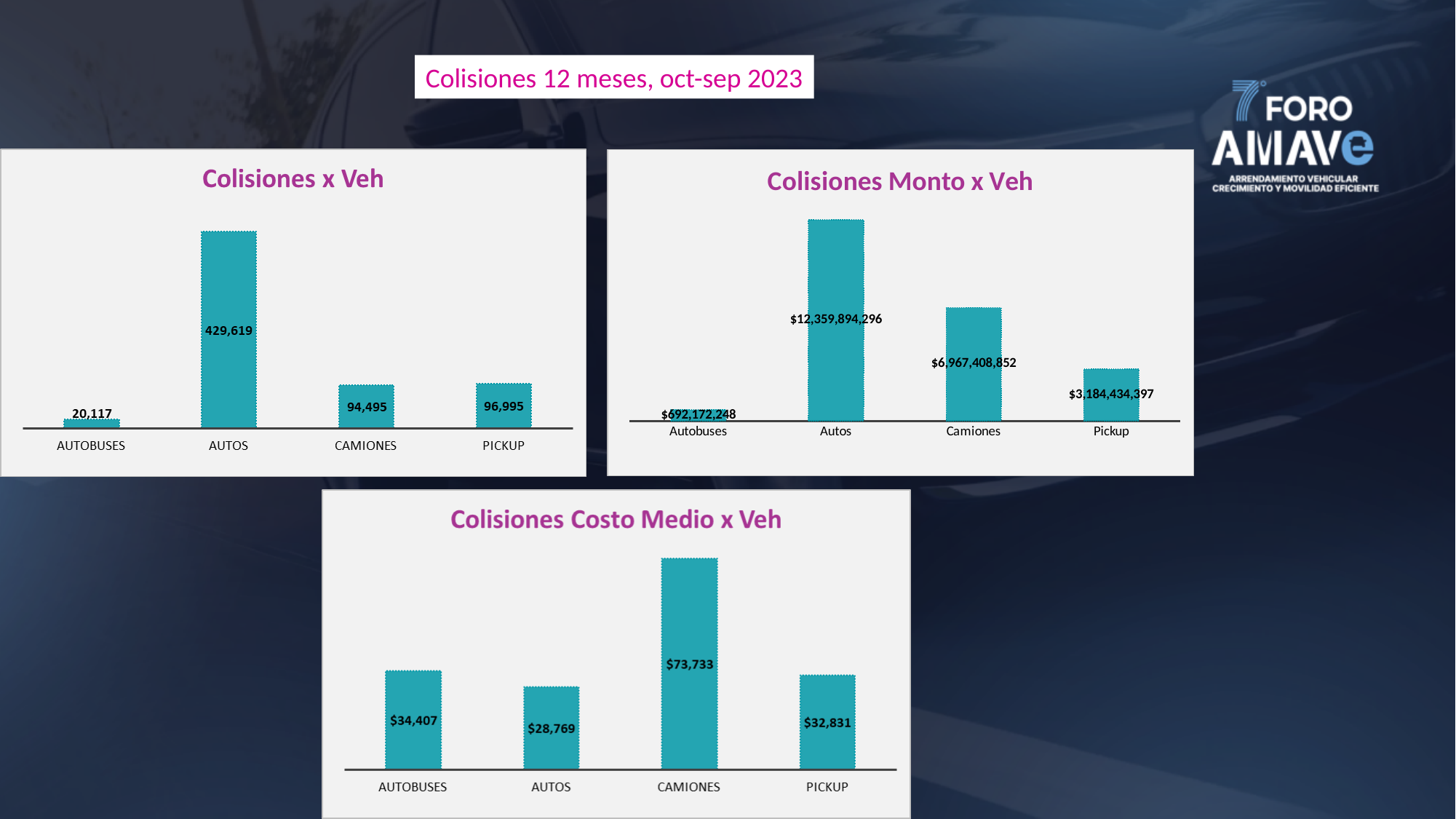
How many categories are shown in the 'Colisiones x Veh' chart? 4 In the 'Colisiones Monto x Veh' chart, what is the value for Camiones? $6,967,408,852 In the 'Colisiones x Veh' chart, what is the value for AUTOS? 429,619 In the 'Colisiones Costo Medio x Veh' chart, which category has the highest value? CAMIONES In the 'Colisiones Monto x Veh' chart, which is larger, Pickup or Camiones? Camiones In the 'Colisiones x Veh' chart, what is the difference between PICKUP and CAMIONES? 2,500 In the 'Colisiones Costo Medio x Veh' chart, what is the value for PICKUP? $32,831 In the 'Colisiones Costo Medio x Veh' chart, what is the difference between CAMIONES and AUTOS? $44,964 What type of chart is 'Colisiones Monto x Veh'? Bar chart In the 'Colisiones Costo Medio x Veh' chart, which category has the lowest value? AUTOS In the 'Colisiones Monto x Veh' chart, which category has the highest value? Autos In the 'Colisiones x Veh' chart, which category has the lowest value? AUTOBUSES